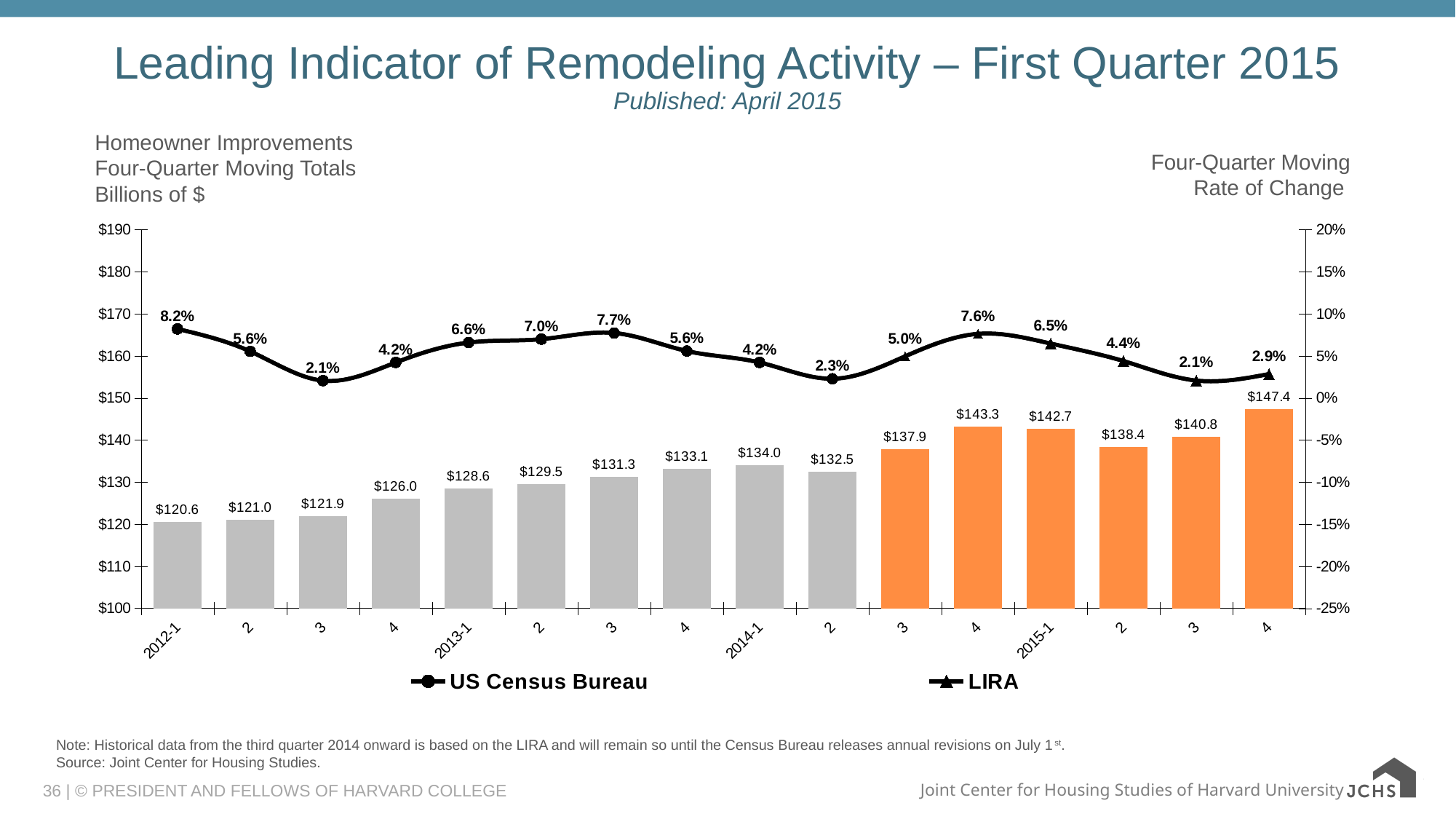
Which quarter has the highest four-quarter moving rate of change? 2012-1 Which quarter has the highest four-quarter moving total? 2015-4 How many quarters are plotted on the x axis? 16 What is the difference between the four-quarter moving totals for 2015-4 and 2015-1? $4.7 Which quarter has the lowest four-quarter moving total? 2012-1 How many series does the legend list? 2 Which is larger, the four-quarter moving total for 2014-4 or for 2015-1? 2015-1 What is the rate of change shown for 2015-4? 2.9% Do the four-quarter moving totals rise or fall from 2012-1 to 2014-1? Rise What is the four-quarter moving total for 2014-1? $134.0 What is the four-quarter moving rate of change shown for 2013-3? 7.7% What kind of chart is shown on the slide? Combined bar and line chart